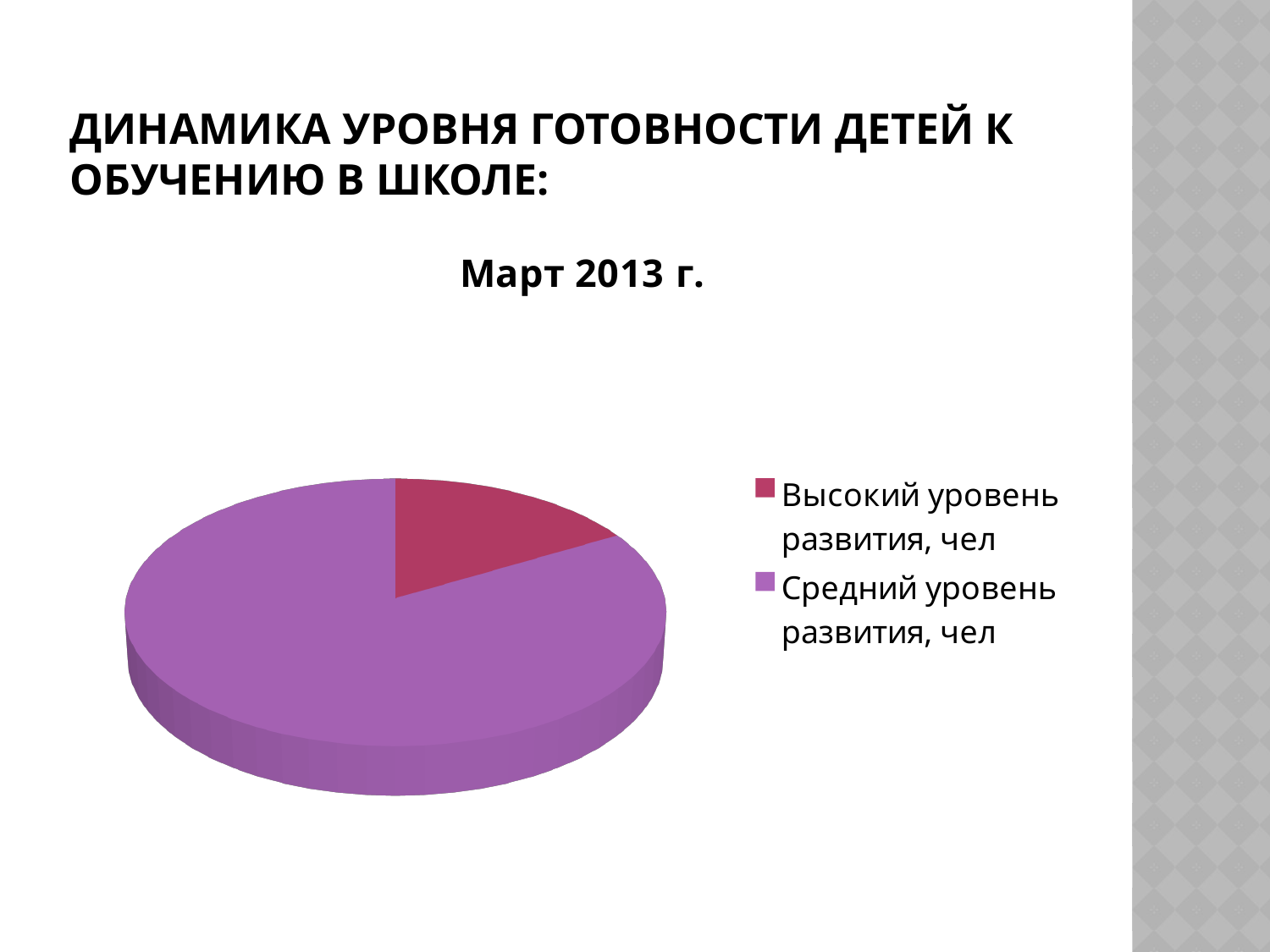
Which is larger: the slice for Высокий уровень развития, чел or the slice for Средний уровень развития, чел? Средний уровень развития, чел What kind of chart is shown on the slide? Pie chart How many entries does the legend list? 2 How many slices does the pie chart have? 2 What colour is the slice for Средний уровень развития, чел? Purple Which category has the smallest slice of the pie? Высокий уровень развития, чел Which category has the largest slice of the pie? Средний уровень развития, чел What is the title of the chart? Март 2013 г.